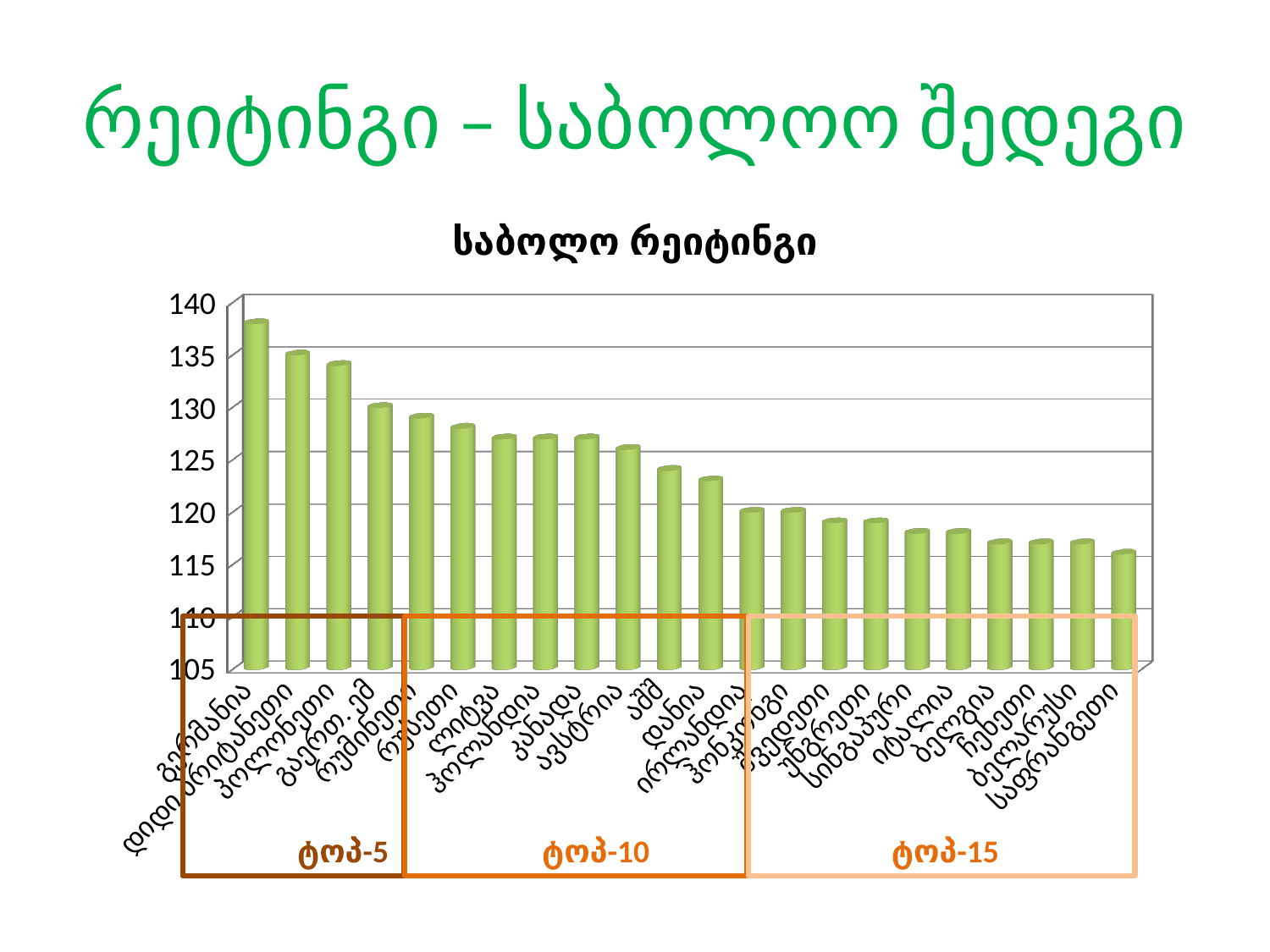
Is the value for სინგაპური greater or less than 120? less Is the value for გერმანია greater or less than 135? greater What is the title of the chart? საბოლო რეიტინგი How many countries (bars) are shown in the chart? 22 What kind of chart is shown on the slide? bar chart Which has the larger value, დანია or ირლანდია? დანია Is the value for რუსეთი greater or less than 130? less What are the labels of the three boxes drawn under the chart? ტოპ-5, ტოპ-10, ტოპ-15 Do the values rise or fall from left to right along the x axis? fall Which country has the highest rating in the chart? გერმანია